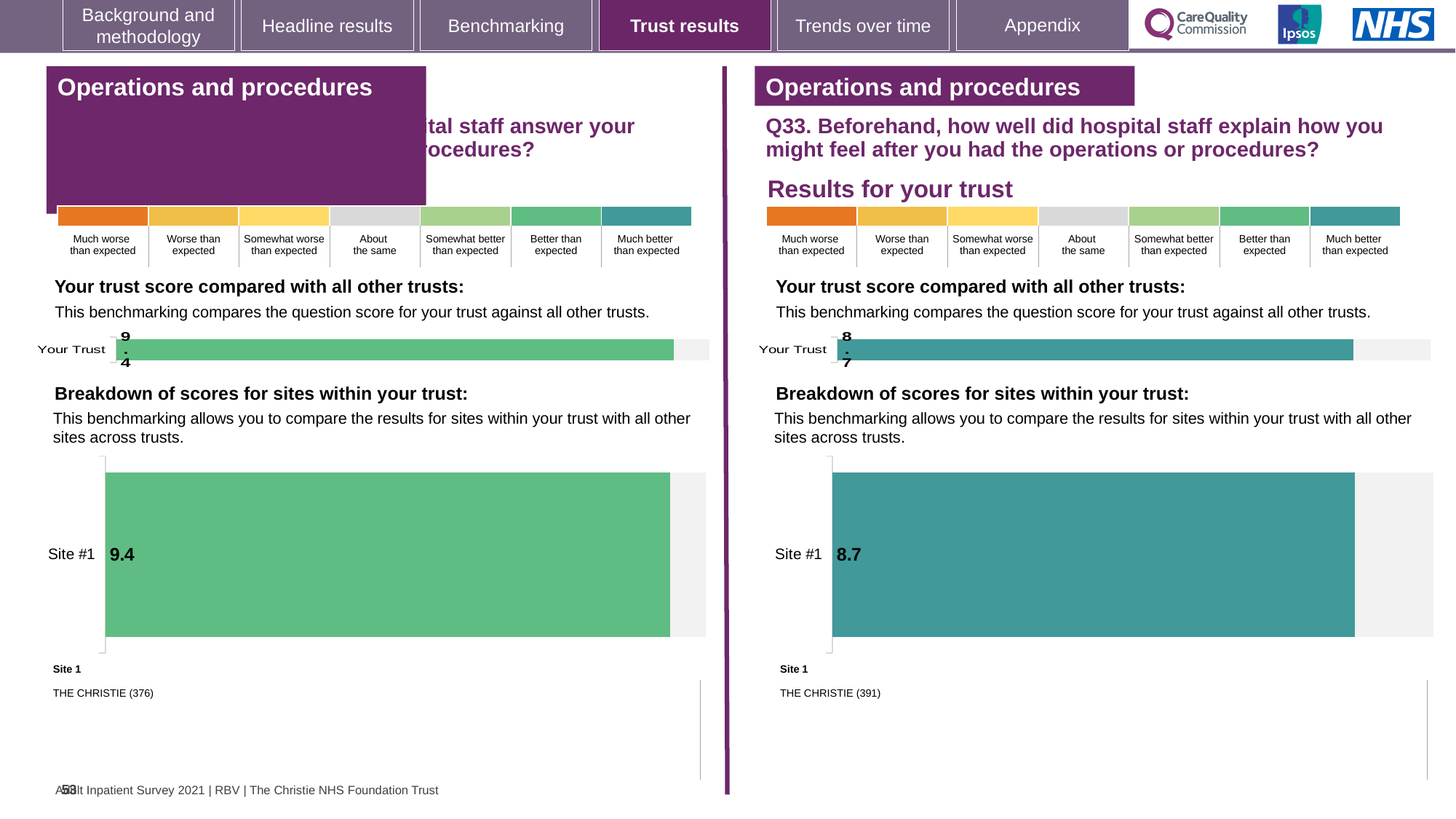
What is the difference between the Your Trust score on the left half of the slide and the Your Trust score on the right half (Q33)? 0.7 What type of chart is used to show the Site #1 score on the right half of the slide? Bar chart Is the Your Trust score on the right half of the slide (Q33) greater or less than 9? less What is the name of the site listed as Site 1 on the right half of the slide (Q33)? THE CHRISTIE (391) On the left half of the slide, what is the score shown for Your Trust in the 'Your trust score compared with all other trusts' chart? 9.4 Which is larger: the Site #1 score in the left breakdown chart or the Site #1 score in the right (Q33) breakdown chart? The left chart (9.4) In the left 'Breakdown of scores for sites within your trust' chart, what is the score for Site #1? 9.4 How many sites are shown in the left 'Breakdown of scores for sites within your trust' chart? 1 In the right 'Breakdown of scores for sites within your trust' chart (Q33), what is the score for Site #1? 8.7 What is the name of the site listed as Site 1 on the left half of the slide? THE CHRISTIE (376) On the right half of the slide (Q33), what is the score shown for Your Trust in the 'Your trust score compared with all other trusts' chart? 8.7 How many sites are shown in the right (Q33) 'Breakdown of scores for sites within your trust' chart? 1